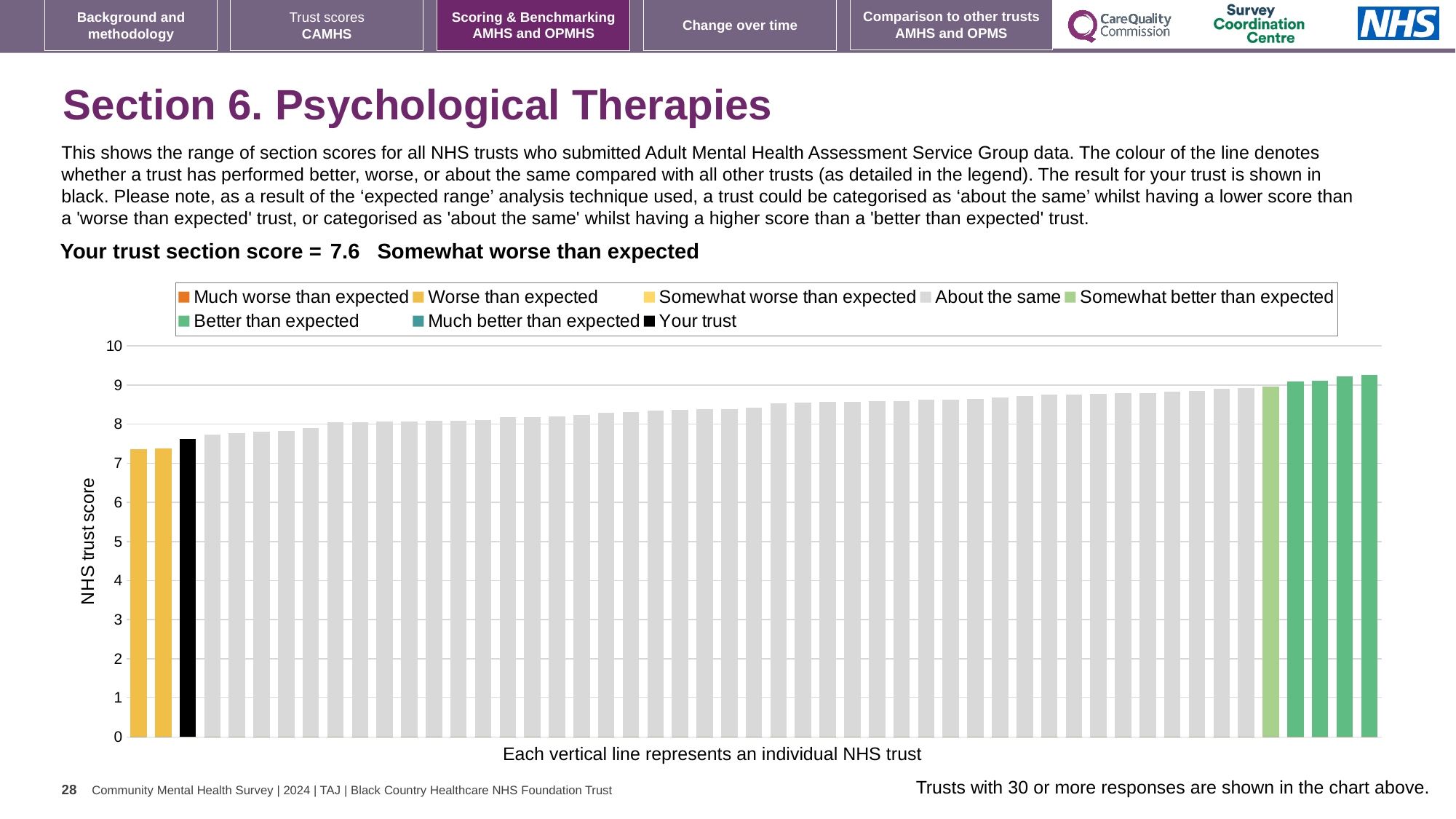
How many entries does the chart legend list? 8 What kind of chart is shown on the slide? bar chart Which category does your trust's section score fall into? Somewhat worse than expected How many bars are coloured as 'Worse than expected' (yellow)? 2 Do the bar values rise or fall from left to right along the x axis? rise Is the value of the black 'Your trust' bar greater or less than 7? greater What is the label on the vertical axis of the chart? NHS trust score Is the value of the shortest bar in the chart greater or less than 8? less What is the section score for your trust shown on the slide? 7.6 What colour is the bar representing your trust? black Is the value of the black 'Your trust' bar greater or less than 8? less